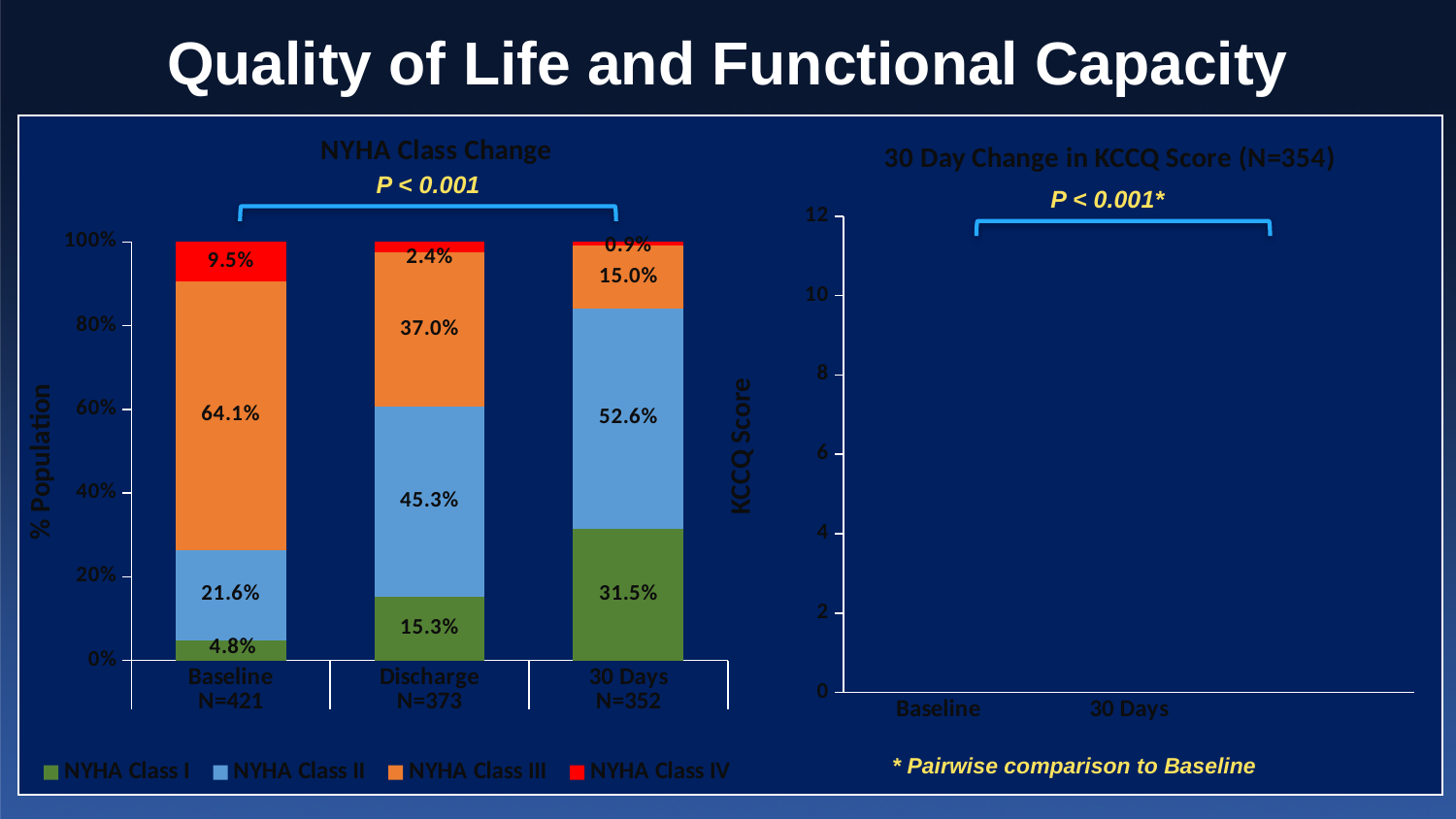
In the NYHA Class Change chart, does the NYHA Class III share rise or fall from Baseline to 30 Days? Fall What kind of chart is the NYHA Class Change chart? Stacked bar chart In the NYHA Class Change chart, what percentage of the population was NYHA Class I at 30 Days? 31.5% In the NYHA Class Change chart, by how many percentage points does the NYHA Class I share at 30 Days exceed the NYHA Class I share at Baseline? 26.7 percentage points How many series does the legend of the NYHA Class Change chart list? 4 In the NYHA Class Change chart, what percentage of the population was NYHA Class III at Baseline? 64.1% How many time points (categories) are shown on the x axis of the NYHA Class Change chart? 3 In the NYHA Class Change chart, at which time point is the NYHA Class IV share lowest? 30 Days In the NYHA Class Change chart, what is the NYHA Class IV value at Discharge? 2.4% What is the sample size (N) shown for the Baseline category in the NYHA Class Change chart? N=421 In the NYHA Class Change chart, at which time point is the NYHA Class II share highest? 30 Days In the NYHA Class Change chart, at Discharge, which is larger: the NYHA Class II share or the NYHA Class III share? NYHA Class II